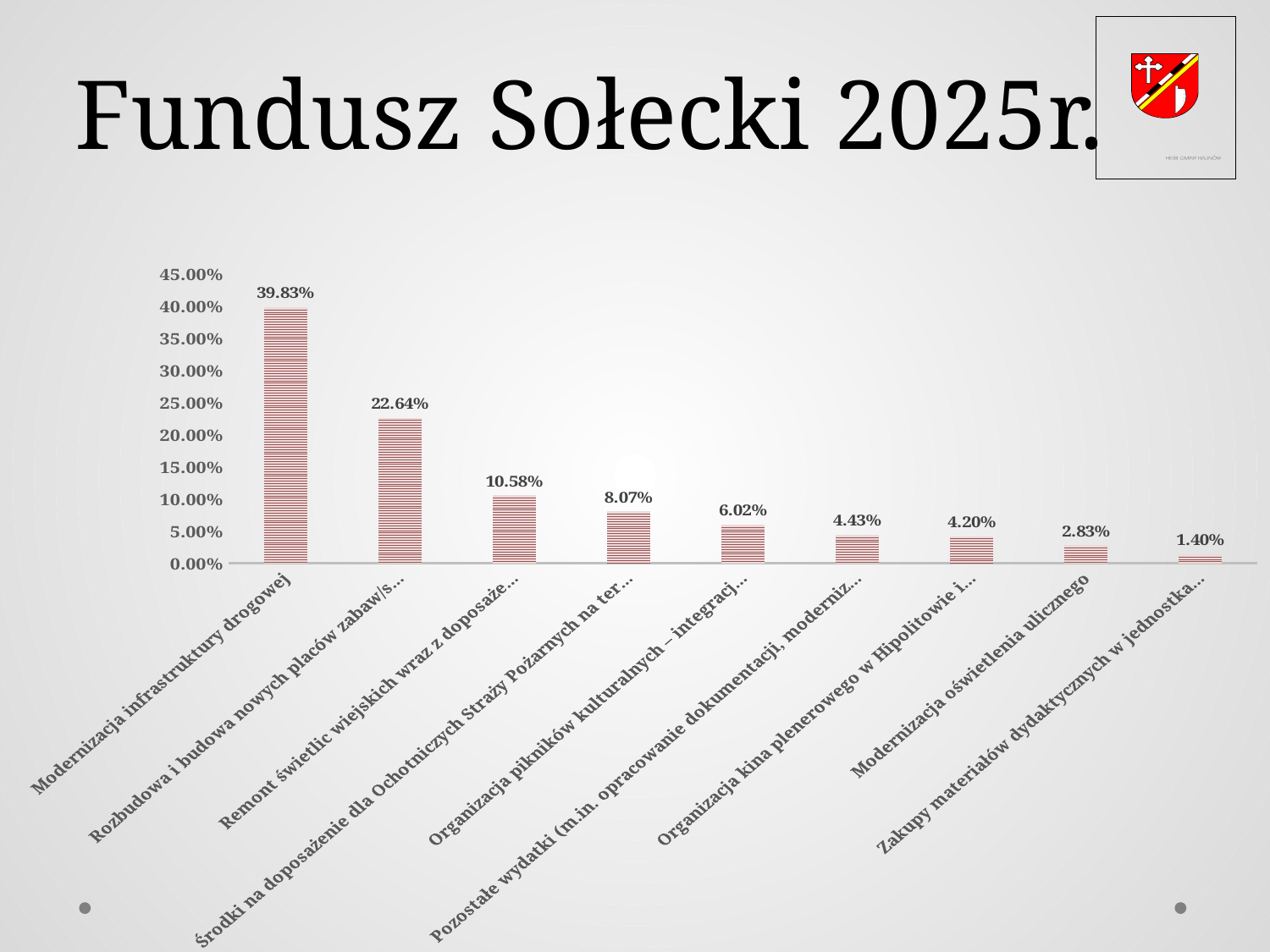
Which category has the highest value? Modernizacja infrastruktury drogowej Which is larger: the value for Remont świetlic wiejskich wraz z doposaże... or the value for Modernizacja oświetlenia ulicznego? Remont świetlic wiejskich wraz z doposaże... Is the value for Rozbudowa i budowa nowych placów zabaw/s... greater or less than 20.00%? greater What is the value for Modernizacja infrastruktury drogowej? 39.83% Do the values rise or fall from left to right along the x axis? fall What is the title of the slide? Fundusz Sołecki 2025r. What is the difference between the values for Modernizacja infrastruktury drogowej and Rozbudowa i budowa nowych placów zabaw/s...? 17.19% How many categories are shown in the chart? 9 What is the value for the bar labelled Organizacja kina plenerowego w Hipolitowie i...? 4.20% What is the value for Modernizacja oświetlenia ulicznego? 2.83% What kind of chart is shown on the slide? bar chart Which category has the lowest value? Zakupy materiałów dydaktycznych w jednostka...